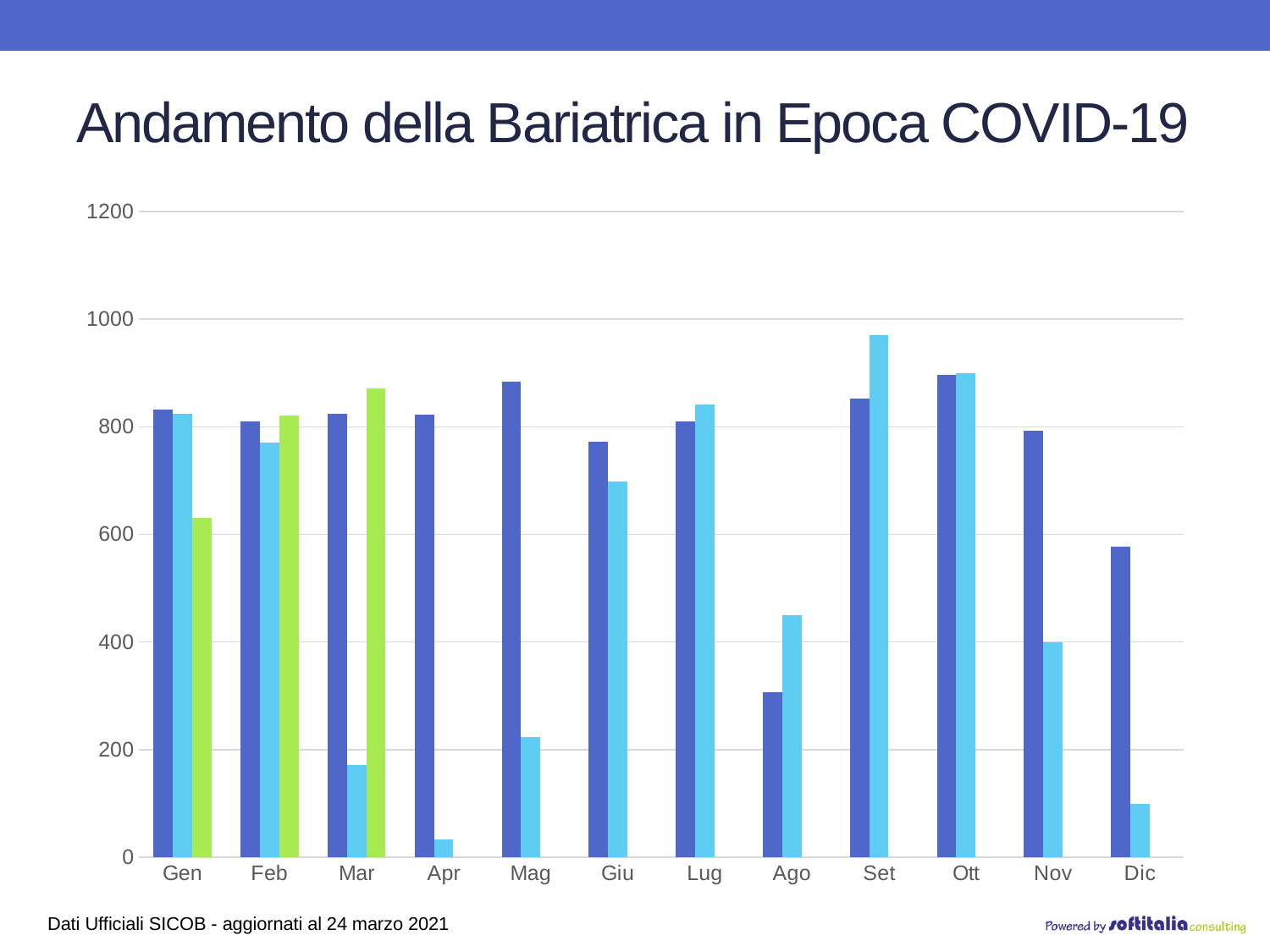
Is the light blue bar for Mar greater or less than 200? less In which month is the light blue bar the lowest? Apr In which month is the dark blue bar the lowest? Ago Is the light blue bar for Set greater or less than 900? greater What is the title of the chart? Andamento della Bariatrica in Epoca COVID-19 How many months are shown on the x axis of the chart? 12 Is the dark blue bar for Ago greater or less than 400? less What kind of chart is shown on the slide? bar chart In which month is the light blue bar the highest? Set In Ago, which bar is taller, the dark blue one or the light blue one? light blue Do the dark blue bars rise or fall from Ott to Dic? fall